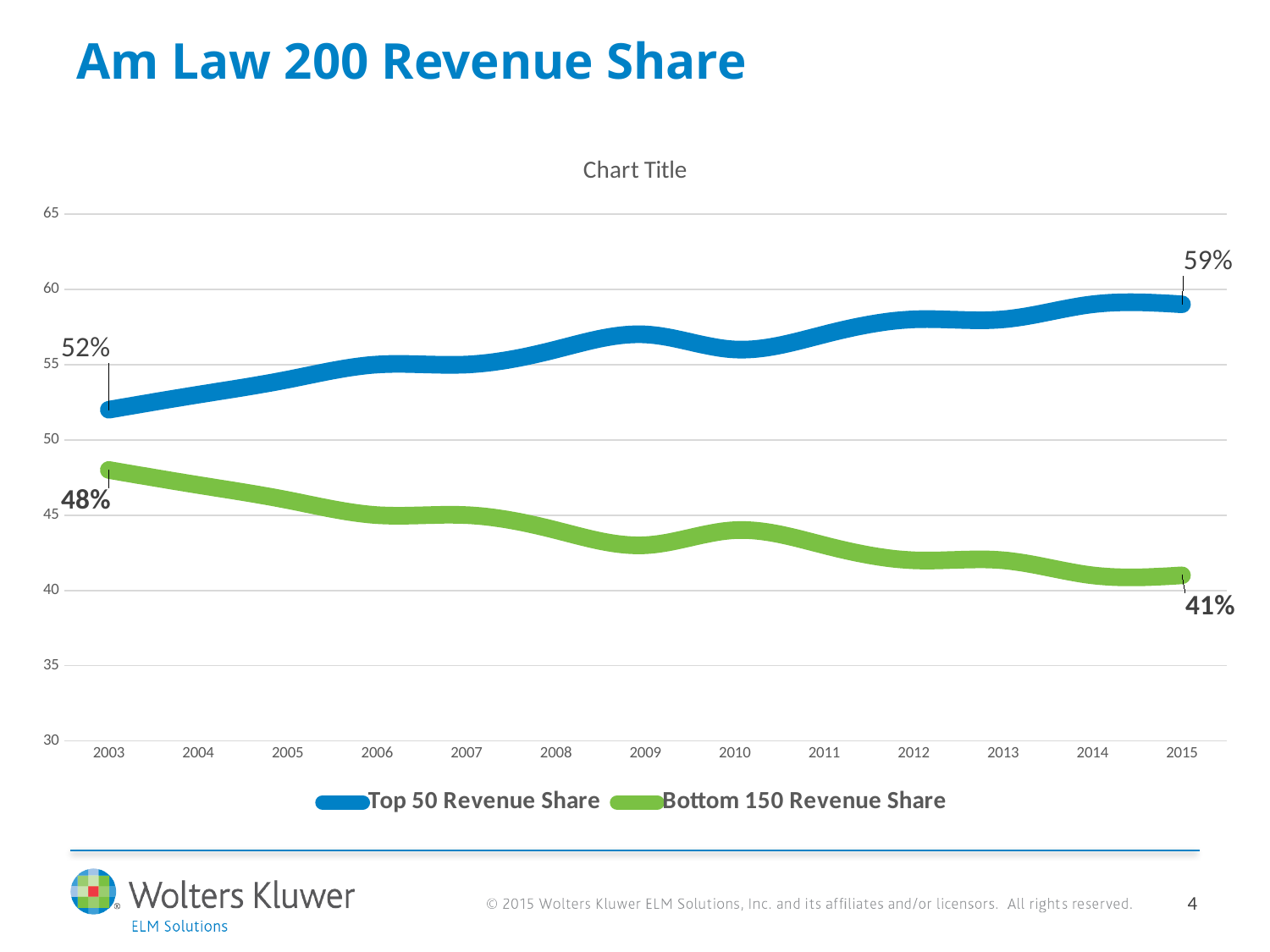
Does the Bottom 150 Revenue Share rise or fall from 2003 to 2015? fall What is the Bottom 150 Revenue Share in 2015? 41% What is the Top 50 Revenue Share in 2003? 52% What kind of chart is shown on the slide? line chart Does the Top 50 Revenue Share rise or fall from 2003 to 2015? rise In 2015, which series has the larger value, Top 50 Revenue Share or Bottom 150 Revenue Share? Top 50 Revenue Share By how many percentage points did the Bottom 150 Revenue Share decrease from 2003 to 2015? 7 What is the Top 50 Revenue Share in 2015? 59% How many years are shown on the x axis? 13 How many series does the legend list? 2 By how many percentage points did the Top 50 Revenue Share increase from 2003 to 2015? 7 What is the Bottom 150 Revenue Share in 2003? 48%